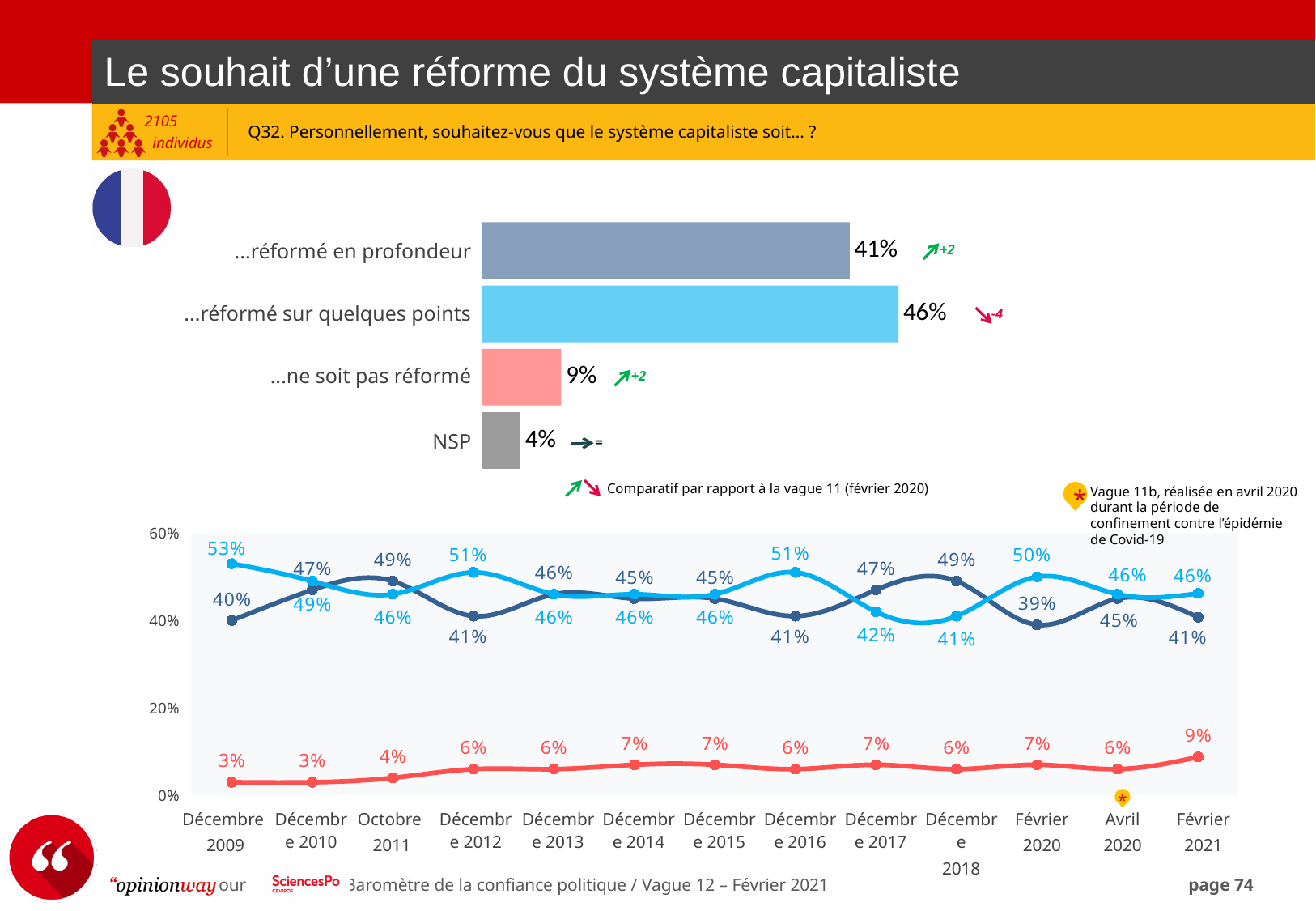
In the line chart, what is the value of the dark blue line for Février 2020? 39% How many categories does the bar chart show? 4 In the bar chart, which category has the lowest value? NSP In the line chart, what is the value of the light blue line for Décembre 2009? 53% In the bar chart, what is the difference between "...réformé sur quelques points" and "...réformé en profondeur"? 5 percentage points What kind of chart is the top chart on the slide? Bar chart How many time points are shown on the x axis of the line chart? 13 In the line chart, what is the value of the red line for Février 2021? 9% In the line chart, at which date does the red line reach its highest value? Février 2021 In the line chart, does the red line rise or fall overall from Décembre 2009 to Février 2021? Rise In the bar chart, which category has the highest value? ...réformé sur quelques points In the bar chart, what is the value for "...réformé en profondeur"? 41%